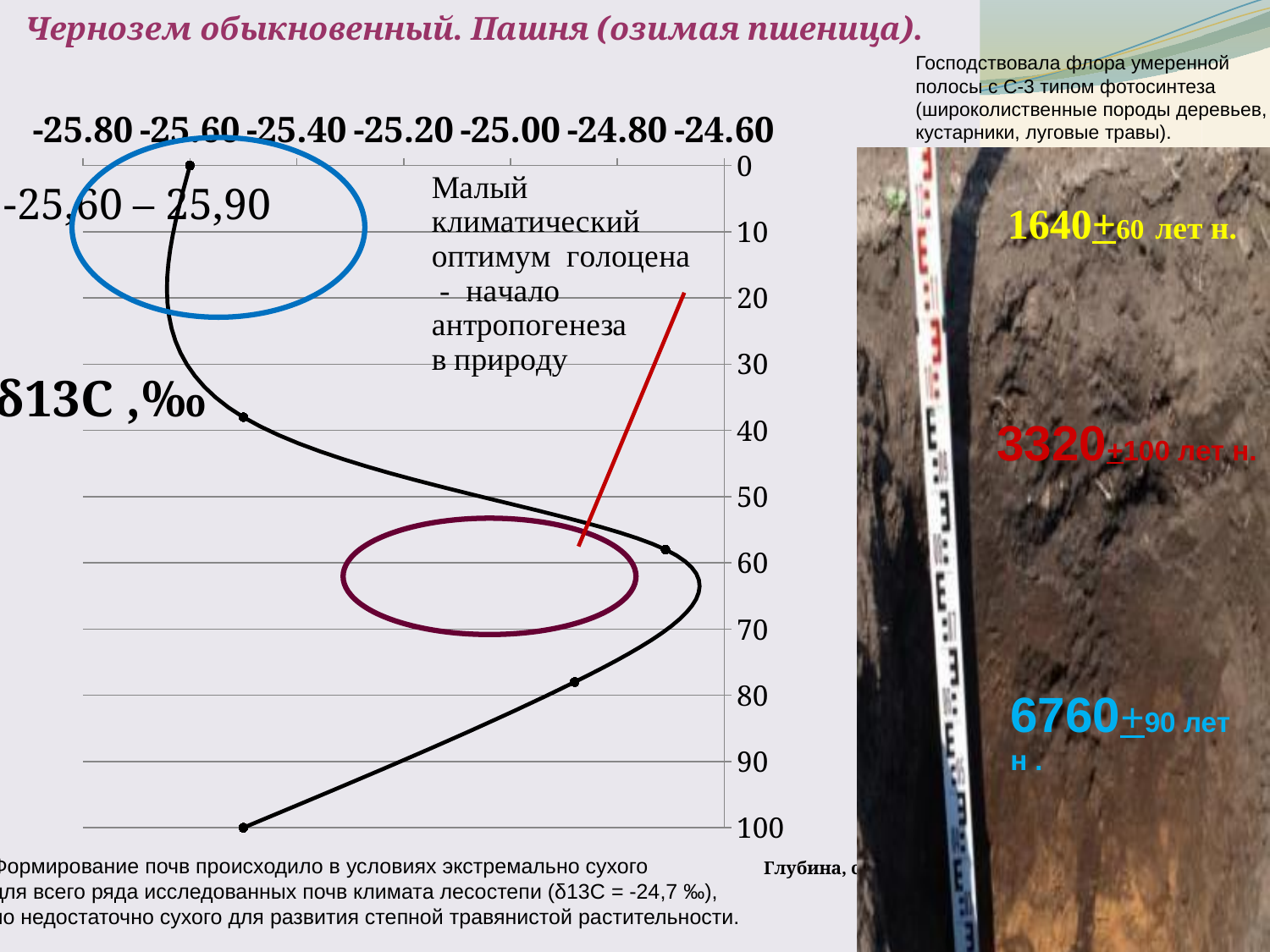
Is the δ13C value at a depth of 60 greater or less than -25.00? greater What kind of chart is shown on the left of the slide? line chart What quantity is plotted on the horizontal axis of the chart? δ13C, ‰ What is the maximum depth value shown on the vertical axis of the chart? 100 What is the leftmost tick value on the horizontal axis of the chart? -25.80 How many data points are marked on the δ13C curve? 5 Going from a depth of 60 down to a depth of 100, does the δ13C value increase or decrease? decrease What is the rightmost tick value on the horizontal axis of the chart? -24.60 Is the δ13C value at a depth of 0 greater or less than -25.40? less Going from a depth of 0 down to a depth of 60, does the δ13C value increase or decrease? increase Is the δ13C value at a depth of 100 greater or less than -25.20? less